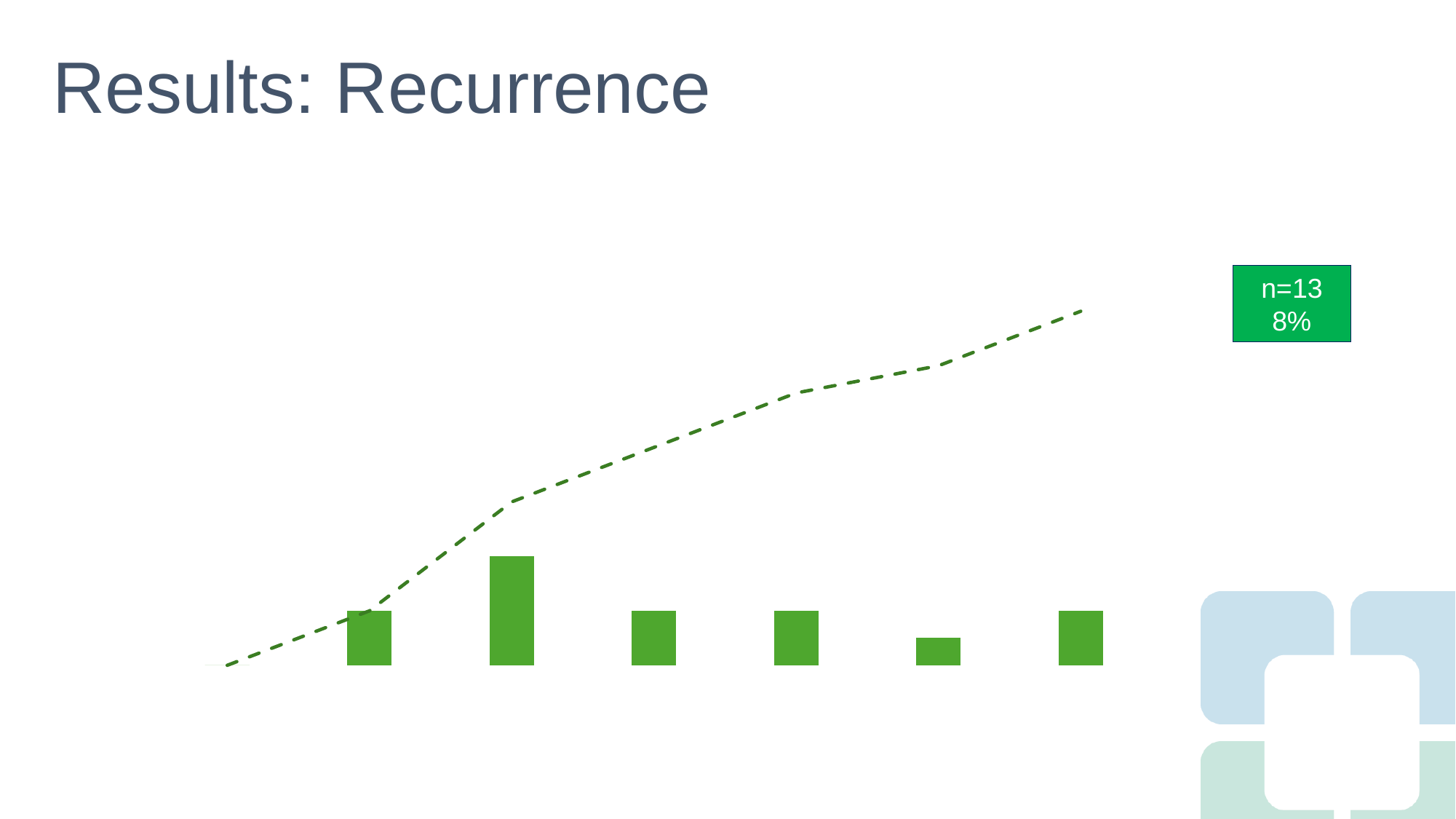
What kind of chart is shown on the slide? A bar chart with a dashed line overlaid Is the second bar from the left taller or shorter than the third bar? Taller Is the sixth bar from the left taller or shorter than the fifth bar? Taller What text is shown in the green annotation box to the right of the chart? n=13 8% Which bar is the tallest in the chart? The second bar from the left What colour are the bars in the chart? Green Is the first bar from the left taller or shorter than the fifth bar? Taller Does the dashed line rise or fall from left to right? It rises How many bars are plotted in the chart? 6 Which bar is the shortest in the chart? The fifth bar from the left